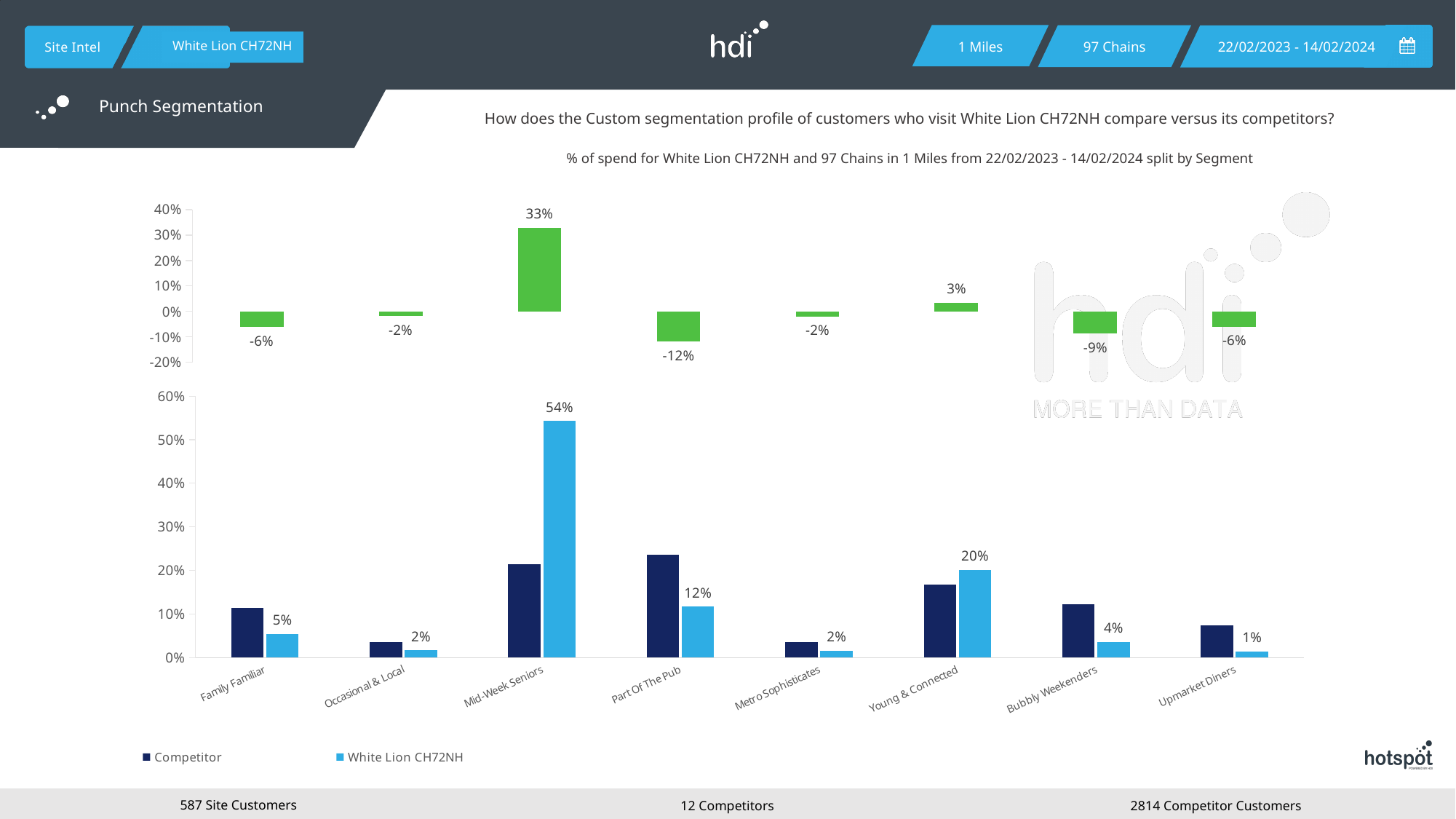
In the top chart, what is the value shown for Part Of The Pub? -12% How many series does the legend of the bottom chart list? 2 In the top chart, which segment has the lowest value? Part Of The Pub In the bottom chart, is the Competitor value for Upmarket Diners greater or less than 10%? less In the bottom chart, is the Competitor value for Part Of The Pub greater or less than 20%? greater In the bottom chart, which is larger for Part Of The Pub: the Competitor value or the White Lion CH72NH value? Competitor In the top chart, what is the value shown for Young & Connected? 3% In the bottom chart, what is the value for White Lion CH72NH in the Mid-Week Seniors segment? 54% In the bottom chart, what is the difference between the White Lion CH72NH values for Mid-Week Seniors and Young & Connected? 34 percentage points How many segments are shown on the x axis of the bottom chart? 8 In the bottom chart, which segment has the highest White Lion CH72NH value? Mid-Week Seniors In the top chart, which segment has the highest value? Mid-Week Seniors